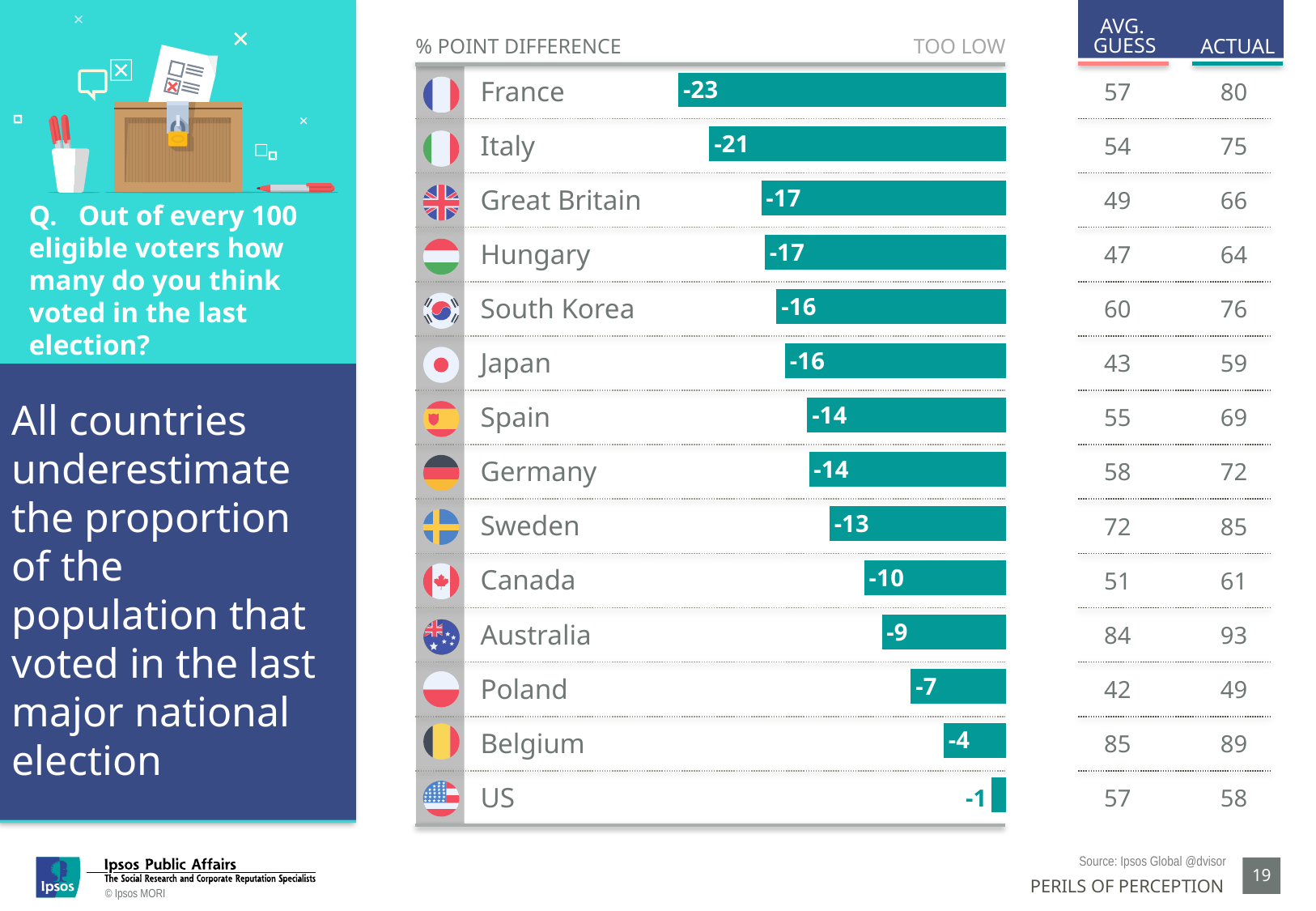
What is the average guess for Australia in the table? 84 What is the % point difference shown for France? -23 What is the actual value for Japan in the table? 59 What is the % point difference shown for Sweden? -13 How many countries are plotted in the bar chart? 14 What is the difference between the % point difference values for France and Italy? 2 What is the difference between the actual value and the average guess for Poland? 7 Which country has the smallest % point difference (the shortest bar)? US What label appears at the top right of the bar chart, above the bars? TOO LOW What kind of chart is used to show the % point difference? bar chart Which country has the largest negative % point difference (the longest bar)? France Which has a larger negative % point difference, Canada or Australia? Canada